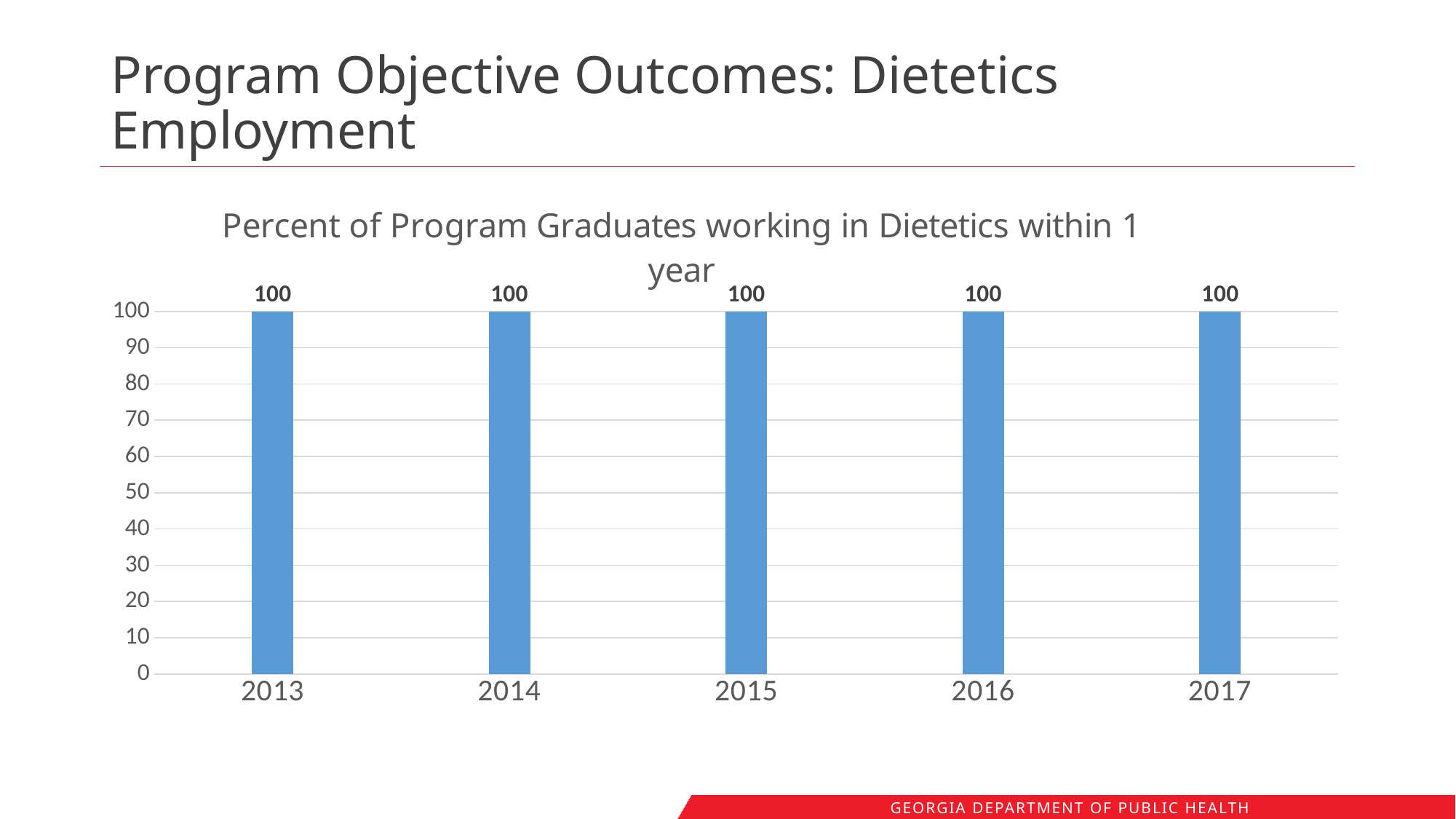
What is the value for 2016? 100 What kind of chart is shown on the slide? bar chart Do the values rise, fall, or stay the same from 2013 to 2017? stay the same What is the value for 2017? 100 What is the difference between the values for 2013 and 2017? 0 What colour are the bars in the chart? blue What is the value for 2014? 100 What is the value for 2015? 100 What is the title of the chart? Percent of Program Graduates working in Dietetics within 1 year How many years are shown on the x axis? 5 What is the value for 2013? 100 Is the value for 2016 greater or less than 50? greater